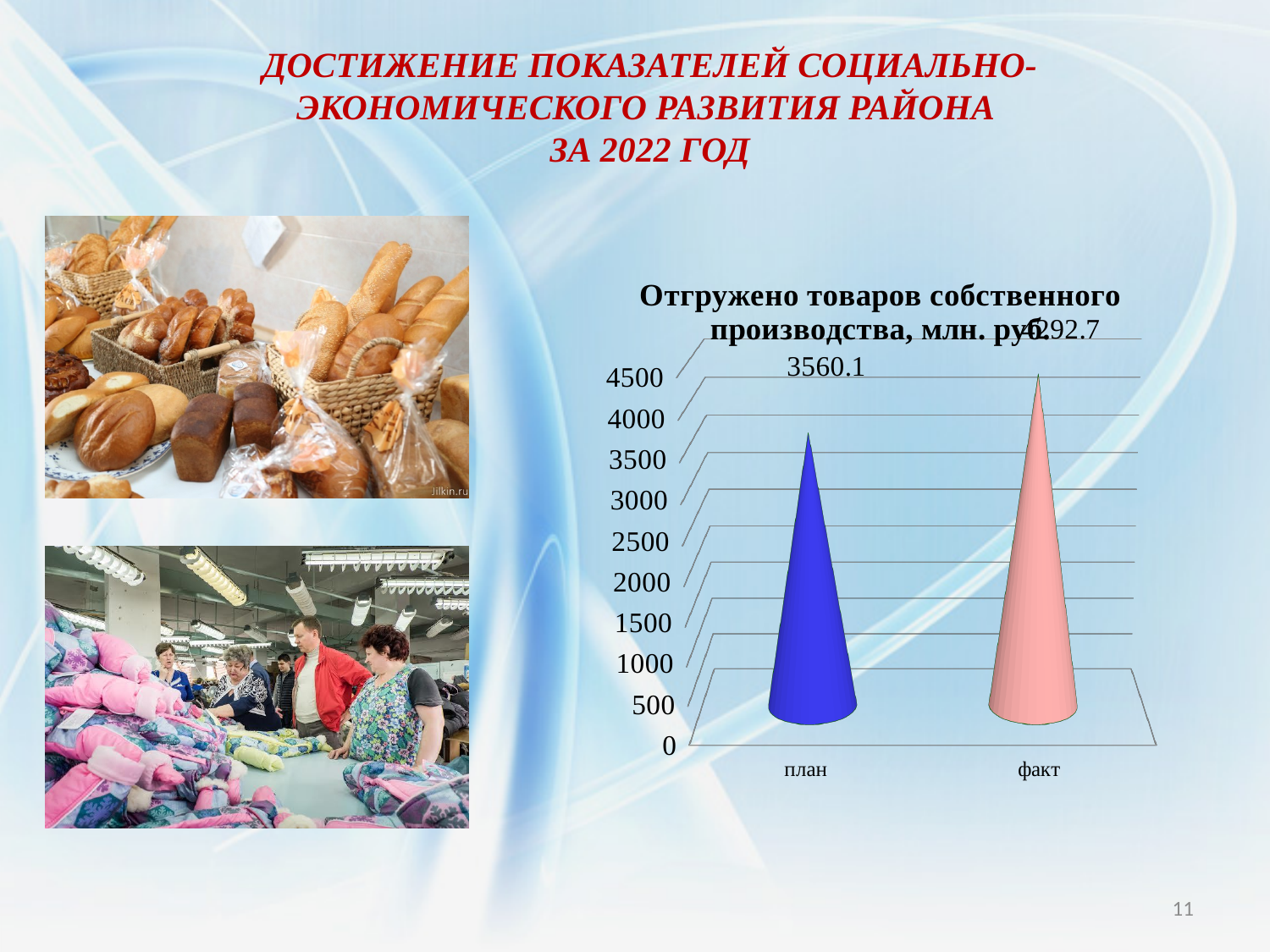
Which category has the highest value in the chart? факт Is the value for план greater or less than 3000? greater Is the value for план greater or less than 4000? less What is the highest tick value shown on the vertical axis of the chart? 4500 Which category has the higher value, план or факт? факт Do the values rise or fall from план to факт? rise How many categories are shown on the x axis of the chart? 2 Is the value for факт greater or less than 4000? greater What kind of chart is shown on the slide? bar chart What is the title of the chart on the slide? Отгружено товаров собственного производства, млн. руб. Which category has the lowest value in the chart? план What is the value for план in the chart 'Отгружено товаров собственного производства, млн. руб.'? 3560.1